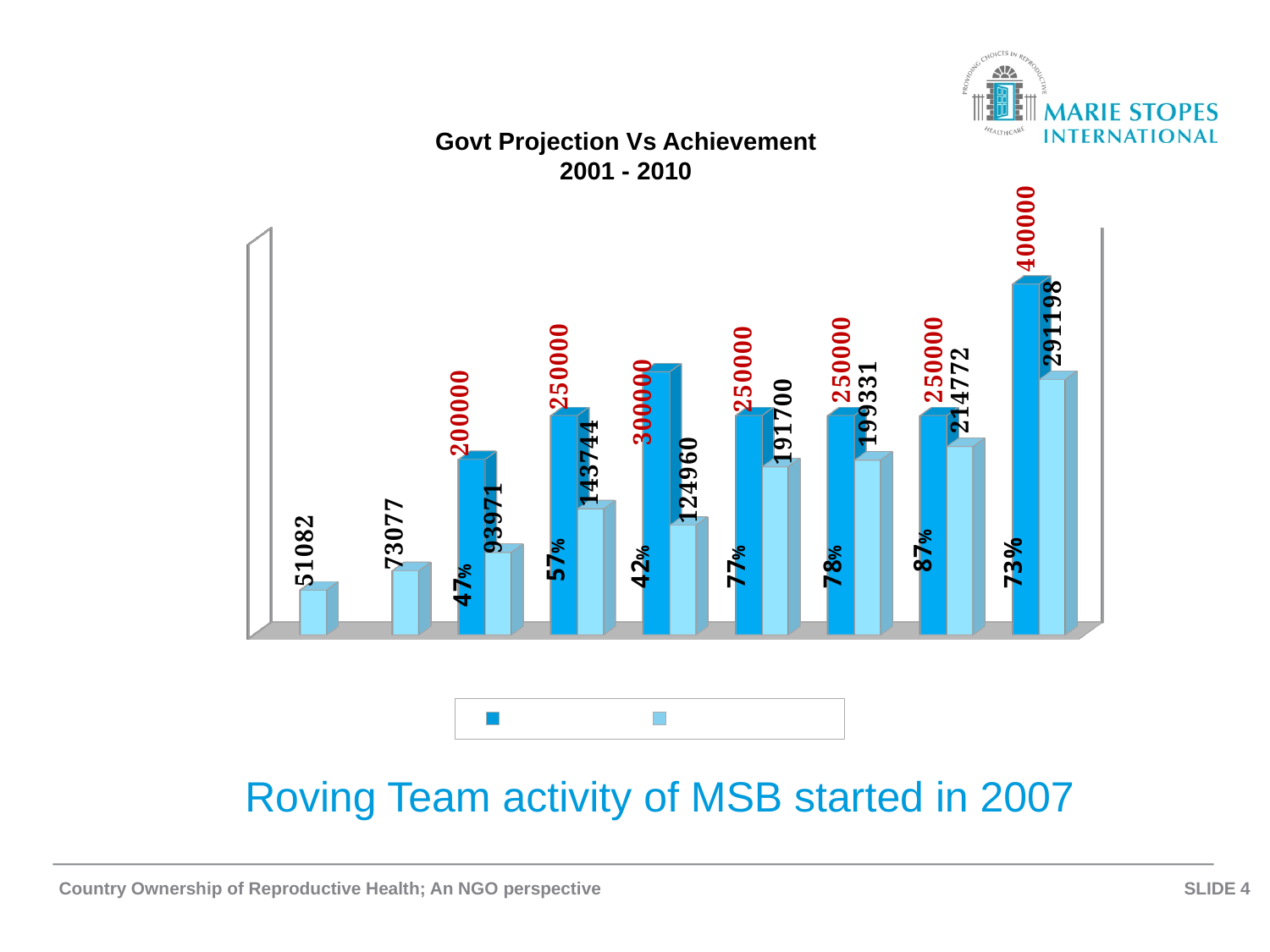
What kind of chart is shown on the slide? bar chart What is the highest value among the light blue bars? 291198 What is the title of the chart? Govt Projection Vs Achievement 2001 - 2010 What is the value of the dark blue bar in the last (rightmost) group? 400000 In the group with the dark blue bar labelled 300000, which bar is larger, the dark blue or the light blue? dark blue How many series does the legend list? 2 What is the highest value among the dark blue bars? 400000 What is the difference between the dark blue bar and the light blue bar in the rightmost group? 108802 What is the lowest value among the light blue bars? 51082 How many groups of bars are plotted in the chart? 9 What is the value of the light blue bar in the first (leftmost) group? 51082 What is the highest percentage label shown in the chart? 87%